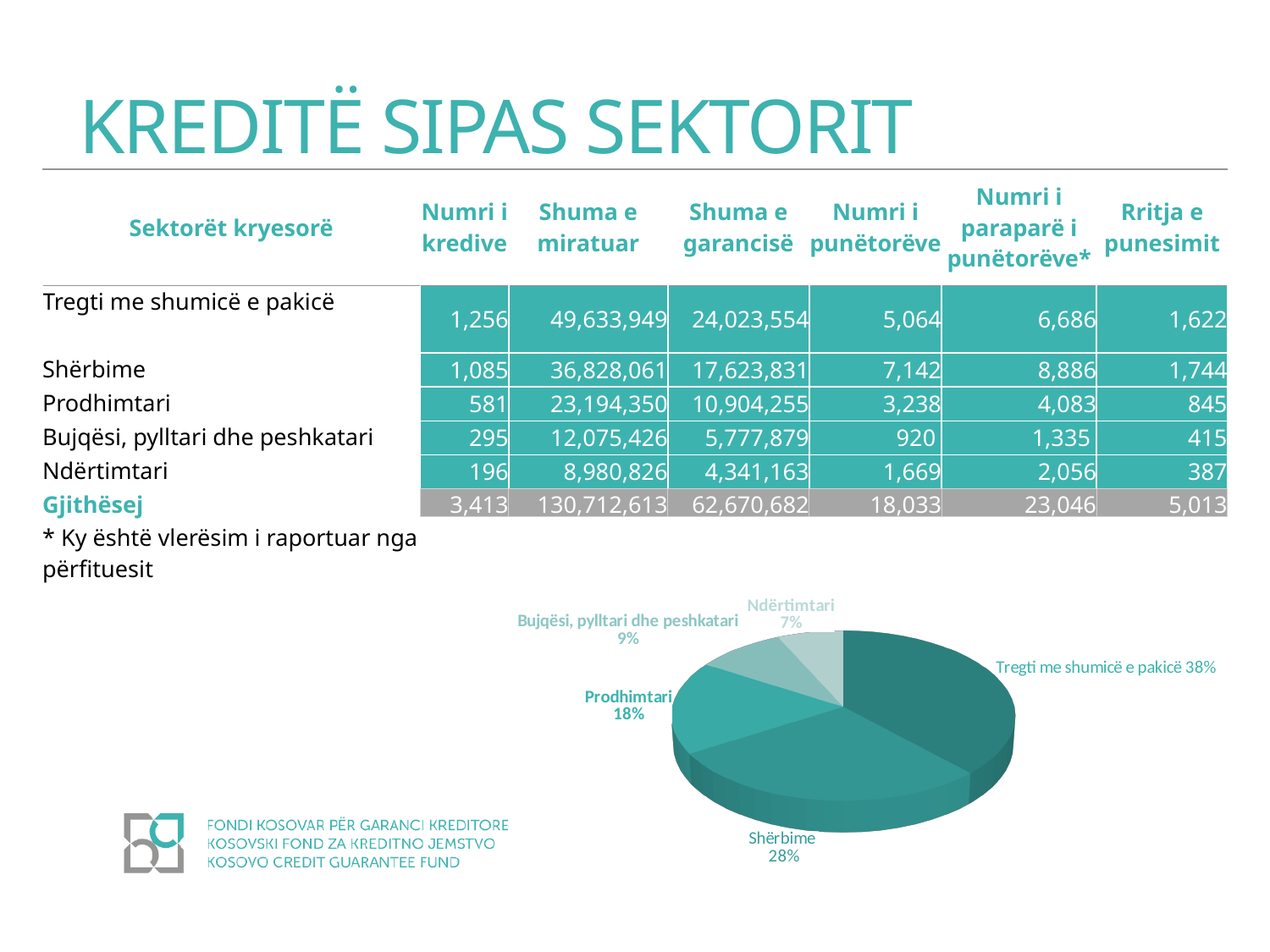
What is the title of the slide containing the pie chart? KREDITË SIPAS SEKTORIT How many slices does the pie chart have? 5 What share of the pie chart does Shërbime have? 28% What share of the pie chart does Tregti me shumicë e pakicë have? 38% Which sector has the largest slice in the pie chart? Tregti me shumicë e pakicë What share of the pie chart does Bujqësi, pylltari dhe peshkatari have? 9% In the pie chart, what is the difference in percentage points between Shërbime and Prodhimtari? 10 In the pie chart, which is larger: Prodhimtari or Bujqësi, pylltari dhe peshkatari? Prodhimtari Which sector has the smallest slice in the pie chart? Ndërtimtari What kind of chart is shown on the slide? pie chart